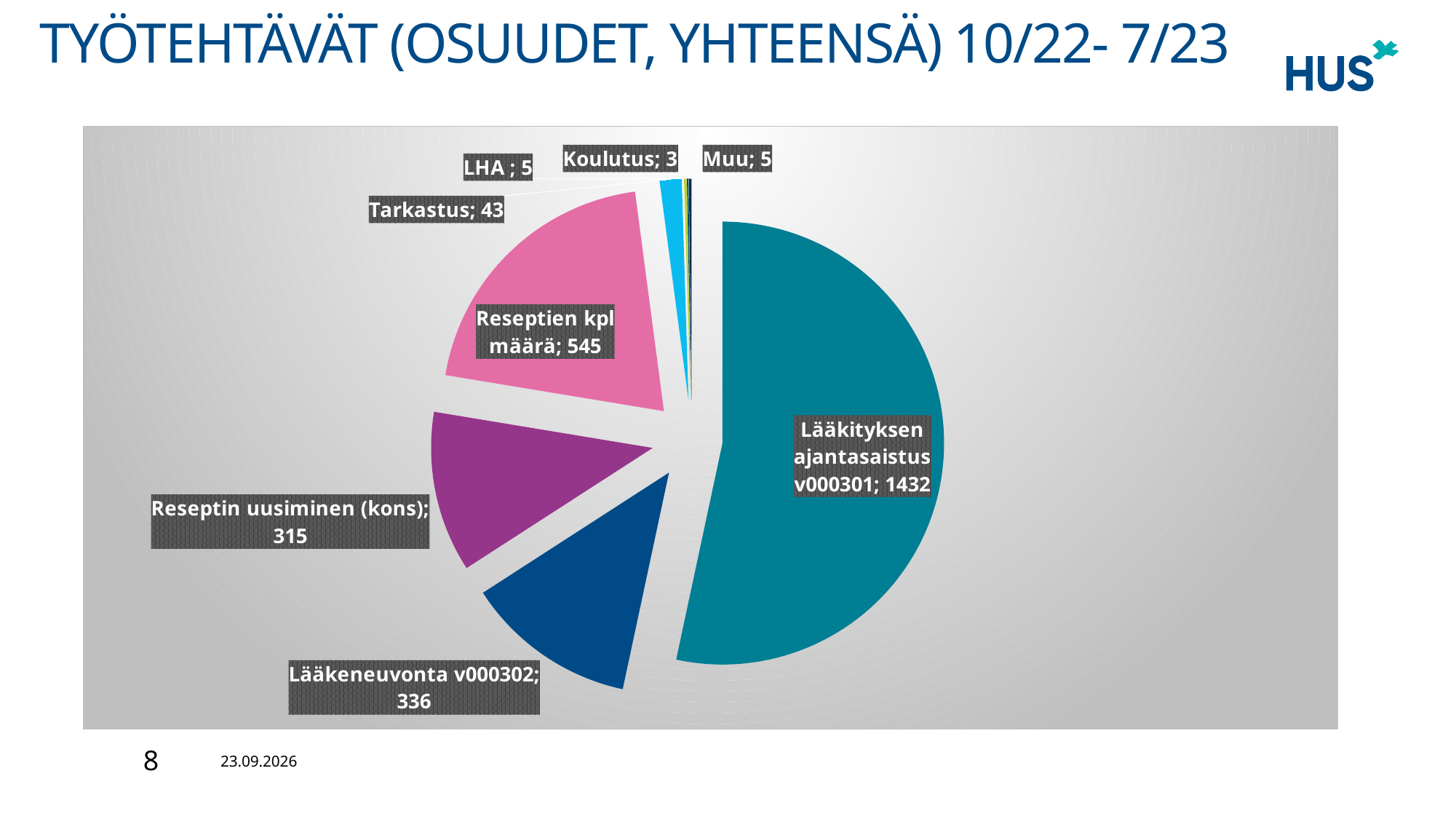
What is the value for Lääkityksen ajantasaistus v000301? 1432 What kind of chart is shown on the slide? pie chart Which category has the smallest value? Koulutus What is the difference between Reseptien kpl määrä and Lääkeneuvonta v000302? 209 How many categories are shown in the pie chart? 8 What is the value for Tarkastus? 43 What is the difference between Lääkeneuvonta v000302 and Reseptin uusiminen (kons)? 21 What is the title of the slide containing the pie chart? TYÖTEHTÄVÄT (OSUUDET, YHTEENSÄ) 10/22- 7/23 Which is larger, Reseptien kpl määrä or Reseptin uusiminen (kons)? Reseptien kpl määrä Which category has the largest slice of the pie? Lääkityksen ajantasaistus v000301 What is the value for Reseptien kpl määrä? 545 What is the value for Lääkeneuvonta v000302? 336